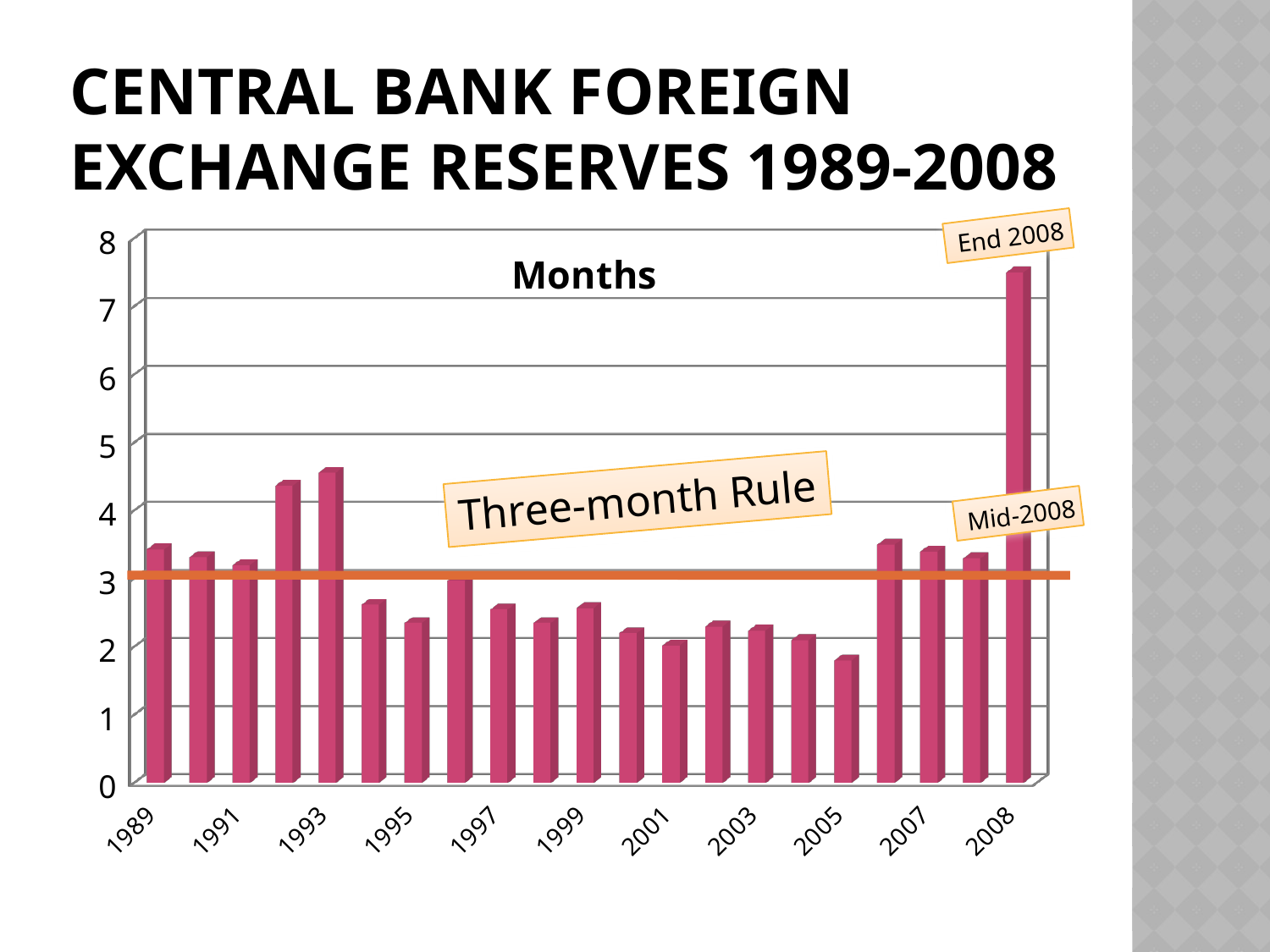
What unit label is shown at the top of the chart's plot area? Months Which bar is the highest in the chart? End 2008 Is the value for 1993 greater or less than 4? greater Is the value for 1989 greater or less than 3? greater Which is larger, the value for 1993 or the value for 1989? 1993 Is the value for 2005 greater or less than 2? less Which is larger, the value for 2005 or the value for 2007? 2007 What kind of chart is shown on the slide? bar chart What is the label on the horizontal line drawn across the chart at 3? Three-month Rule Which year has the lowest bar in the chart? 2005